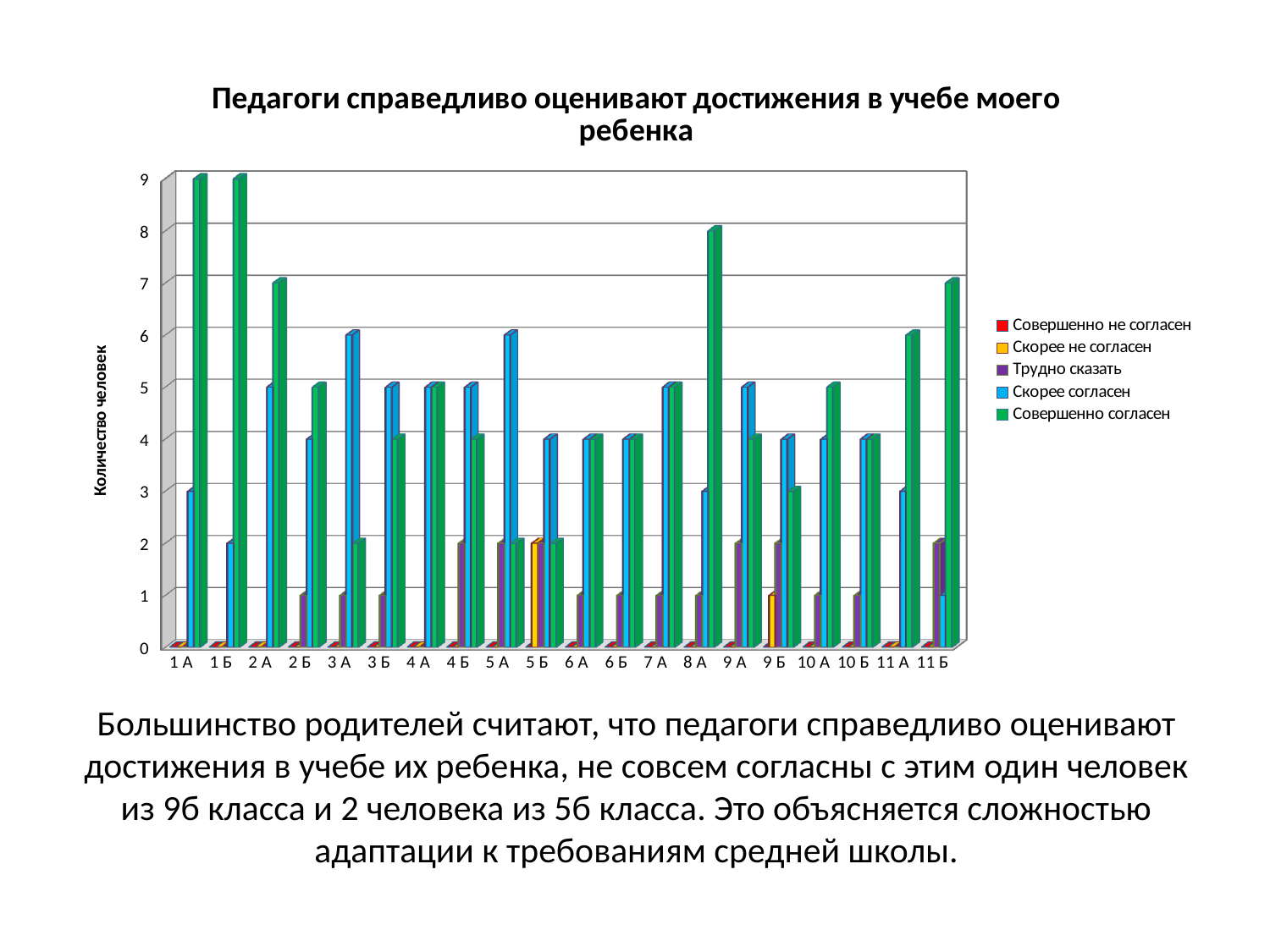
What is the value of "Совершенно согласен" for class 8 А? 8 What is the title of the chart? Педагоги справедливо оценивают достижения в учебе моего ребенка How many class categories are shown along the x axis? 20 What is the value of "Совершенно согласен" for class 2 А? 7 Is the value of "Совершенно согласен" for class 1 Б greater or less than 8? greater How many series does the legend list? 5 Which is larger: "Совершенно согласен" for class 1 А or "Совершенно согласен" for class 3 А? 1 А What is the value of "Скорее не согласен" for class 5 Б? 2 What is the value of "Скорее не согласен" for class 9 Б? 1 What kind of chart is shown on the slide? bar chart Is the value of "Совершенно согласен" for class 3 А greater or less than 4? less What is the label of the vertical axis? Количество человек